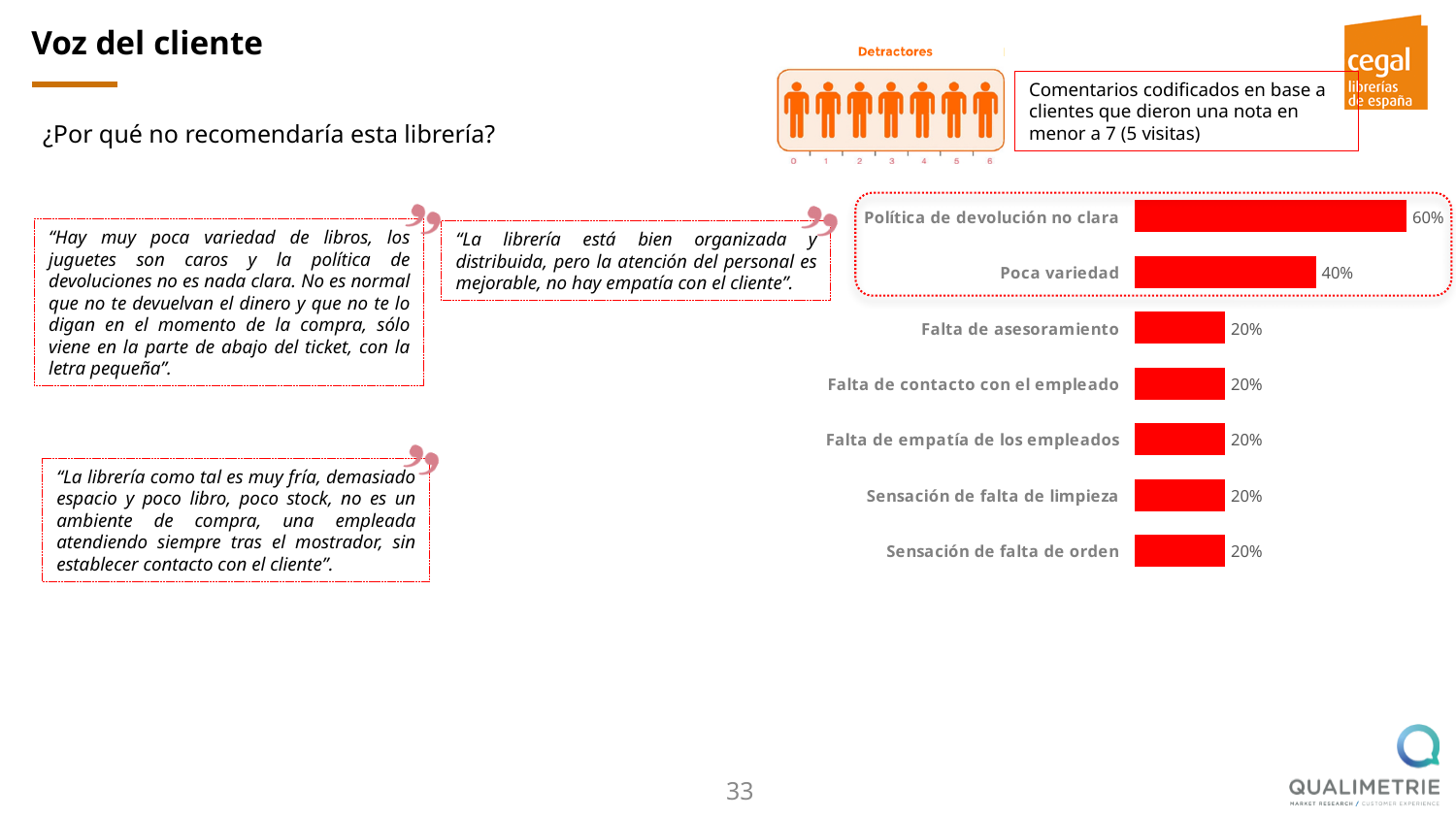
How many categories are shown in the chart? 7 What is the difference between "Política de devolución no clara" and "Poca variedad"? 20% What is the value for "Sensación de falta de orden"? 20% How many categories have a value of 20%? 5 What is the difference between "Poca variedad" and "Falta de empatía de los empleados"? 20% Which category has the highest value? Política de devolución no clara What is the value for "Poca variedad"? 40% What is the value for "Política de devolución no clara"? 60% What is the value for "Falta de asesoramiento"? 20% Which is larger, "Poca variedad" or "Falta de contacto con el empleado"? Poca variedad What colour are the bars in the chart? Red What kind of chart is shown on the slide? Bar chart